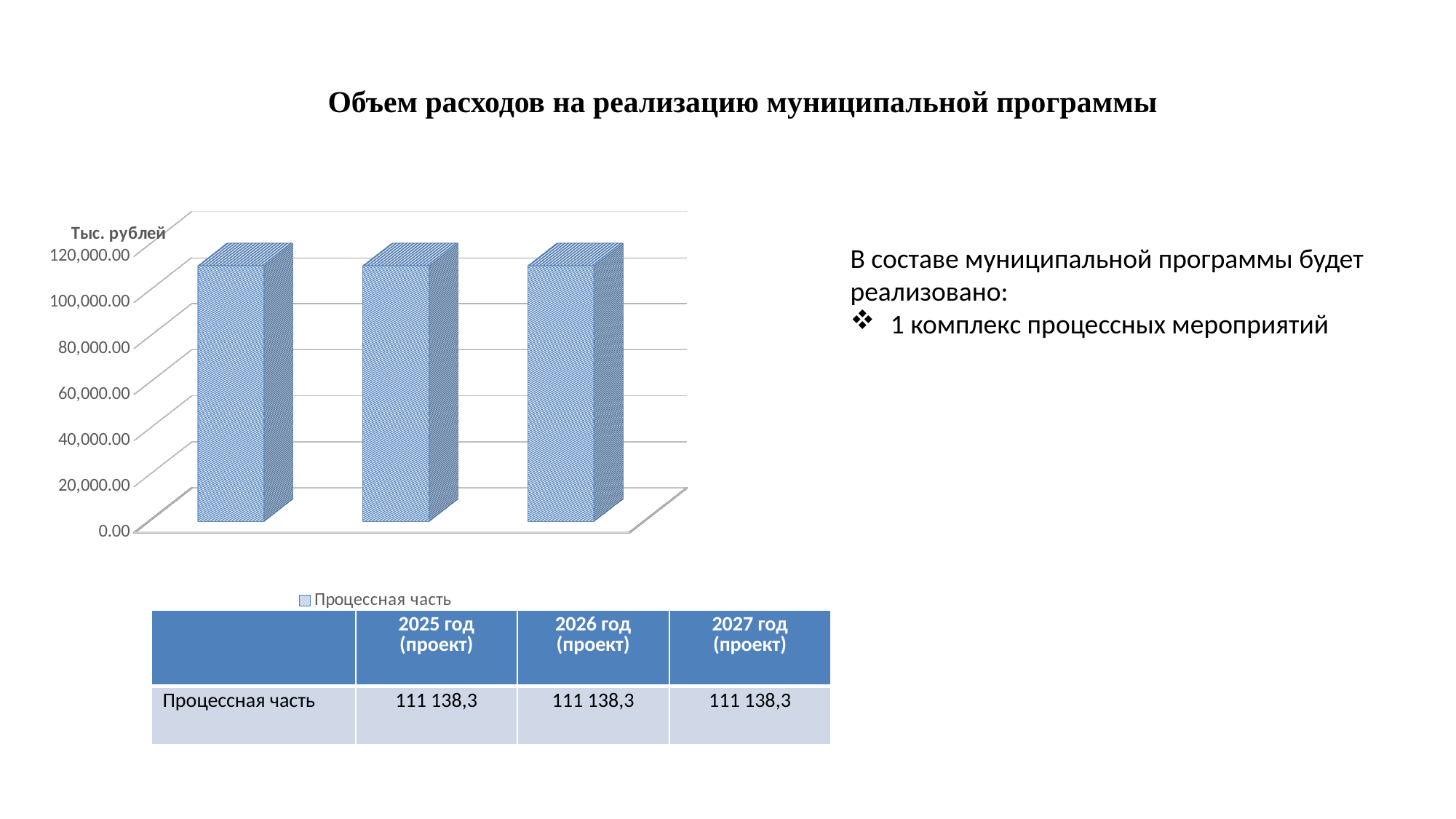
How many bars are plotted in the chart? 3 What is the difference between the values for 2026 год (проект) and 2025 год (проект)? 0 What is the name of the series shown in the chart legend? Процессная часть Is the value for 2025 год (проект) greater or less than 100,000.00? greater Is the value for 2027 год (проект) greater or less than 120,000.00? less What is the value of Процессная часть for 2027 год (проект)? 111 138,3 What is the value of Процессная часть for 2025 год (проект)? 111 138,3 How many series does the chart legend list? 1 What unit is shown on the vertical axis of the chart? Тыс. рублей Do the values rise, fall, or stay the same from 2025 to 2027? stay the same What is the value of Процессная часть for 2026 год (проект)? 111 138,3 What kind of chart is shown on the slide? bar chart